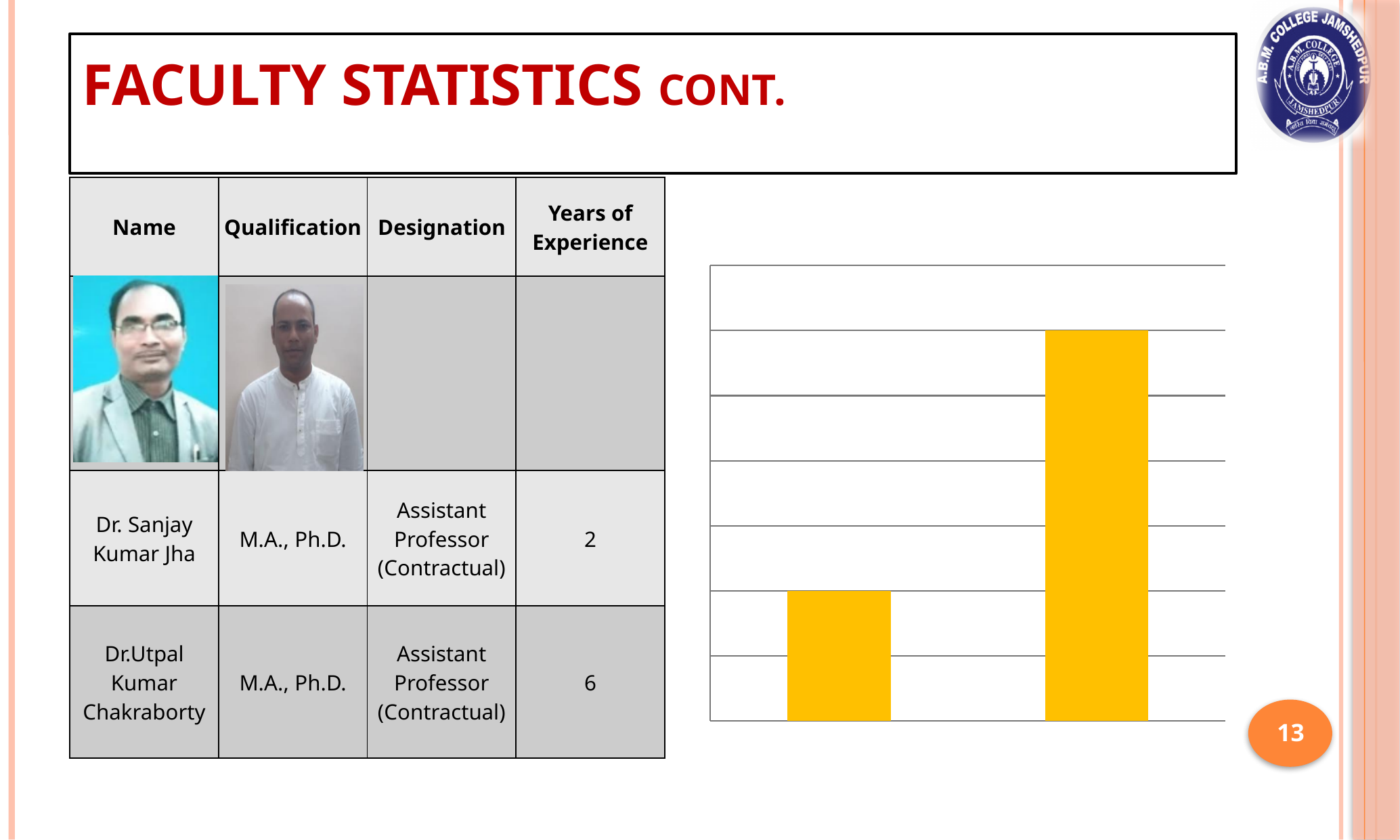
How many bars are plotted in the chart on the right side of the slide? 2 What kind of chart is shown on the right side of the slide? bar chart In the chart on the right side of the slide, which bar is taller, the left bar or the right bar? the right bar Do the bar heights rise or fall from left to right in the chart on the right side of the slide? rise What colour are the bars in the chart on the right side of the slide? yellow In the chart on the right side of the slide, which bar is the shortest? the left bar In the chart on the right side of the slide, which bar is the tallest? the right bar